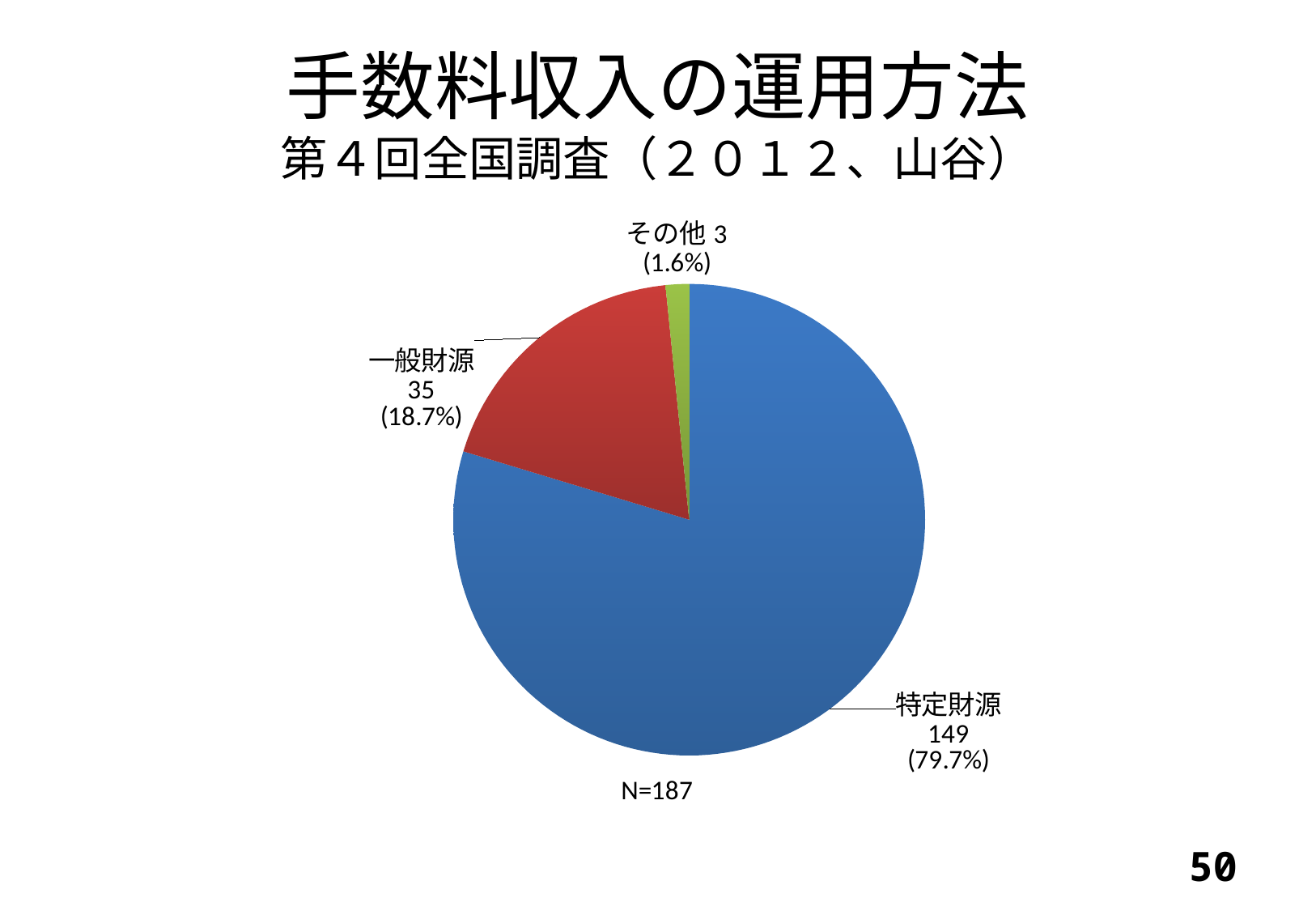
What is the total N shown below the pie chart? N=187 What is the value for その他? 3 Which is larger, the value for 一般財源 or the value for その他? 一般財源 Which category has the smallest slice? その他 What is the value for 特定財源? 149 What share of the pie does 一般財源 represent? 18.7% What is the difference between the values for 特定財源 and 一般財源? 114 What share of the pie does 特定財源 represent? 79.7% How many slices does the pie chart have? 3 Which category has the largest slice? 特定財源 What kind of chart is shown on the slide? pie chart What is the value for 一般財源? 35